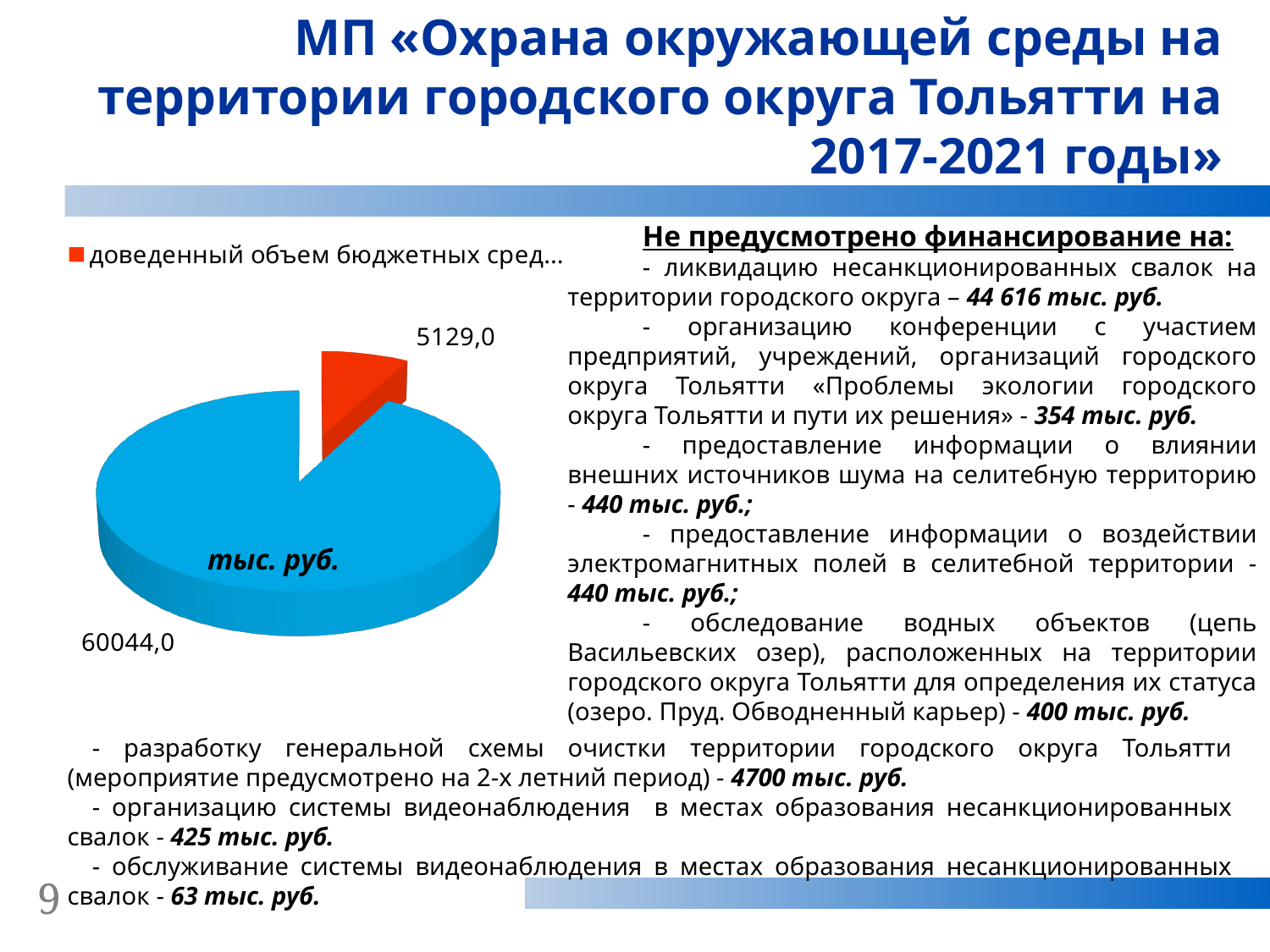
Which is larger in the pie chart, the red slice or the blue slice? the blue slice What value is labelled on the red slice of the pie chart? 5129,0 How many slices does the pie chart have? 2 What kind of chart is shown on the slide? pie chart How many entries does the legend of the pie chart list? 1 What is the total of the two values shown in the pie chart? 65173,0 Which slice of the pie chart has the largest value? the blue slice (60044,0) What value is labelled on the blue slice of the pie chart? 60044,0 What unit label is printed inside the blue slice of the pie chart? тыс. руб. What is the difference between the blue slice value and the red slice value in the pie chart? 54915,0 Which slice of the pie chart has the smallest value? the red slice (5129,0)